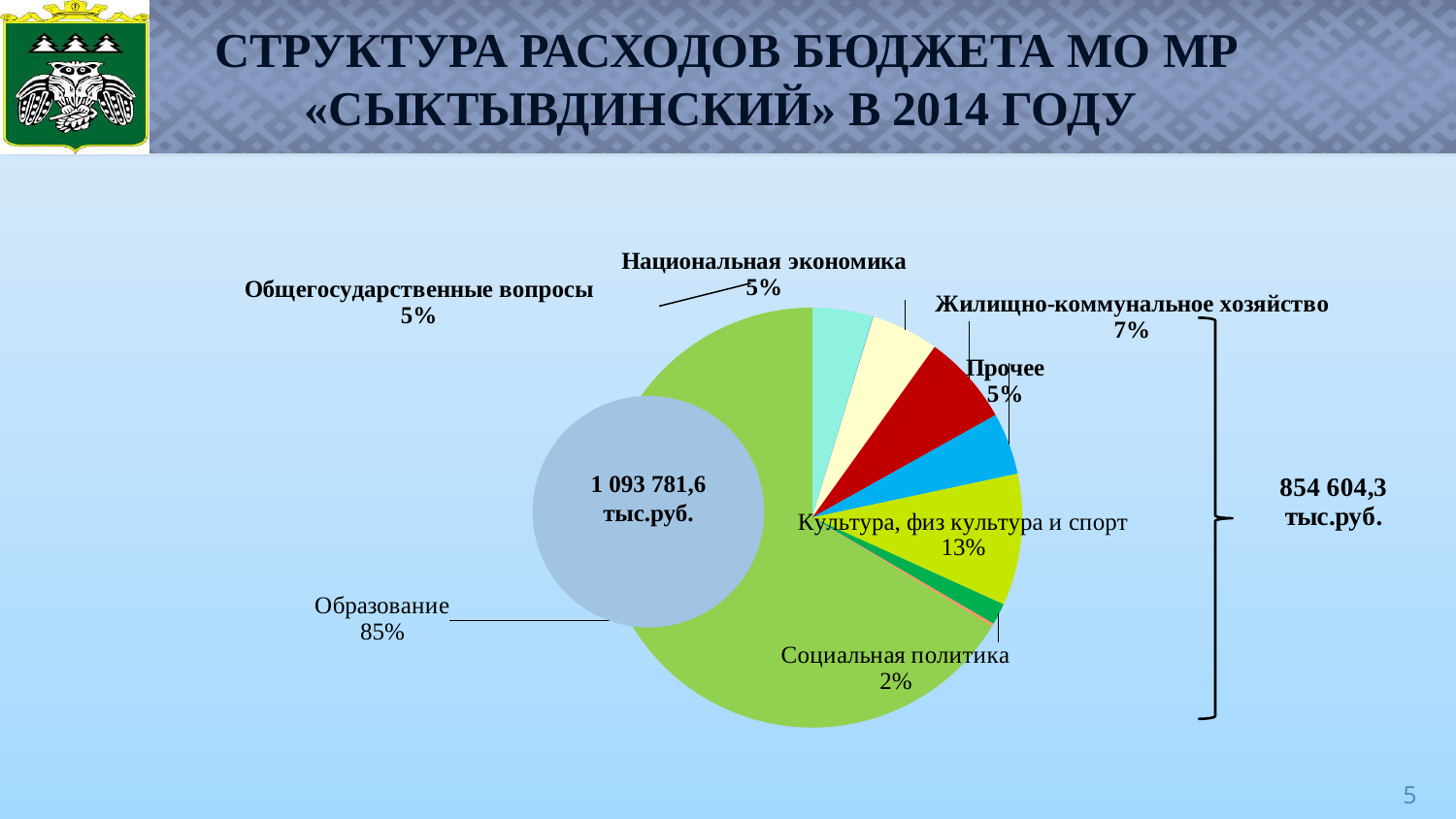
Which category has the largest slice of the pie? Образование Which is larger, Жилищно-коммунальное хозяйство or Прочее? Жилищно-коммунальное хозяйство What is the difference in percentage points between Образование and Культура, физ культура и спорт? 72 What is the value shown for Национальная экономика? 5% What is the value shown for Социальная политика? 2% What type of chart is shown on the slide? pie chart How many categories are labelled on the pie chart? 7 What is the value shown for Культура, физ культура и спорт? 13% What is the value shown for Жилищно-коммунальное хозяйство? 7% What share of the pie does Образование have? 85% What amount in тыс.руб. is shown in the circle inside the pie chart? 1 093 781,6 тыс.руб.